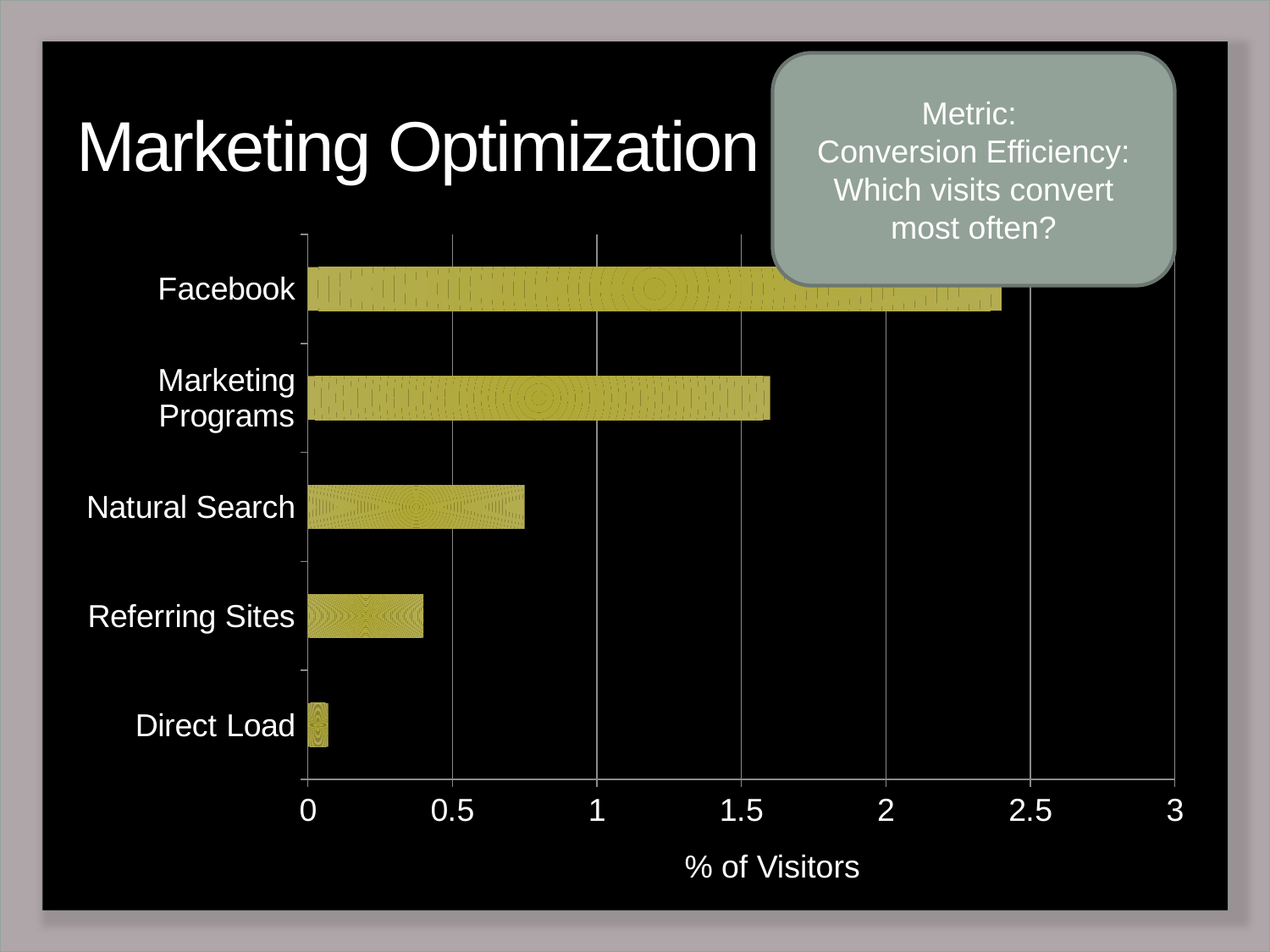
Is the value for Referring Sites greater or less than 0.5? less What kind of chart is shown on the slide? bar chart Is the value for Natural Search greater or less than 1? less Which has a larger value, Marketing Programs or Natural Search? Marketing Programs Is the value for Facebook greater or less than 2? greater Which category has the lowest value in the chart? Direct Load How many categories are plotted in the chart? 5 Which has a larger value, Referring Sites or Direct Load? Referring Sites What is the label of the horizontal axis of the chart? % of Visitors Which category has the highest value in the chart? Facebook